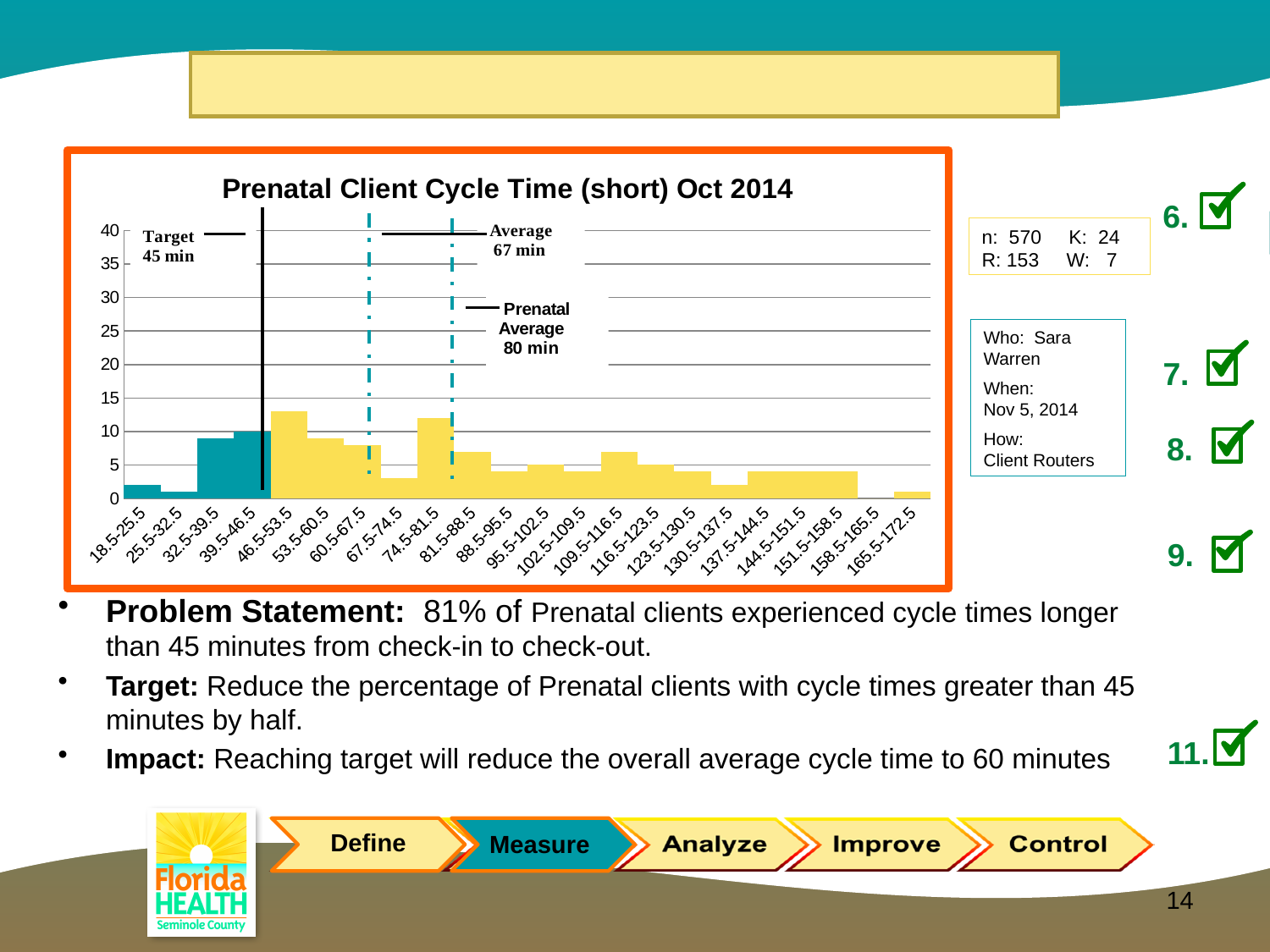
Which category has a larger value, 46.5-53.5 or 67.5-74.5? 46.5-53.5 Is the value for the 74.5-81.5 category greater or less than 10? greater What is the Prenatal Average cycle time labelled on the chart? 80 min Which category has the lowest value on the chart? 158.5-165.5 Is the value for the 46.5-53.5 category greater or less than 10? greater What is the title of the chart? Prenatal Client Cycle Time (short) Oct 2014 What kind of chart is shown on the slide? bar chart How many cycle-time categories are shown on the x axis of the chart? 22 What target value is marked by the solid vertical line on the chart? 45 min Is the value for the 67.5-74.5 category greater or less than 5? less Which category has a larger value, 32.5-39.5 or 25.5-32.5? 32.5-39.5